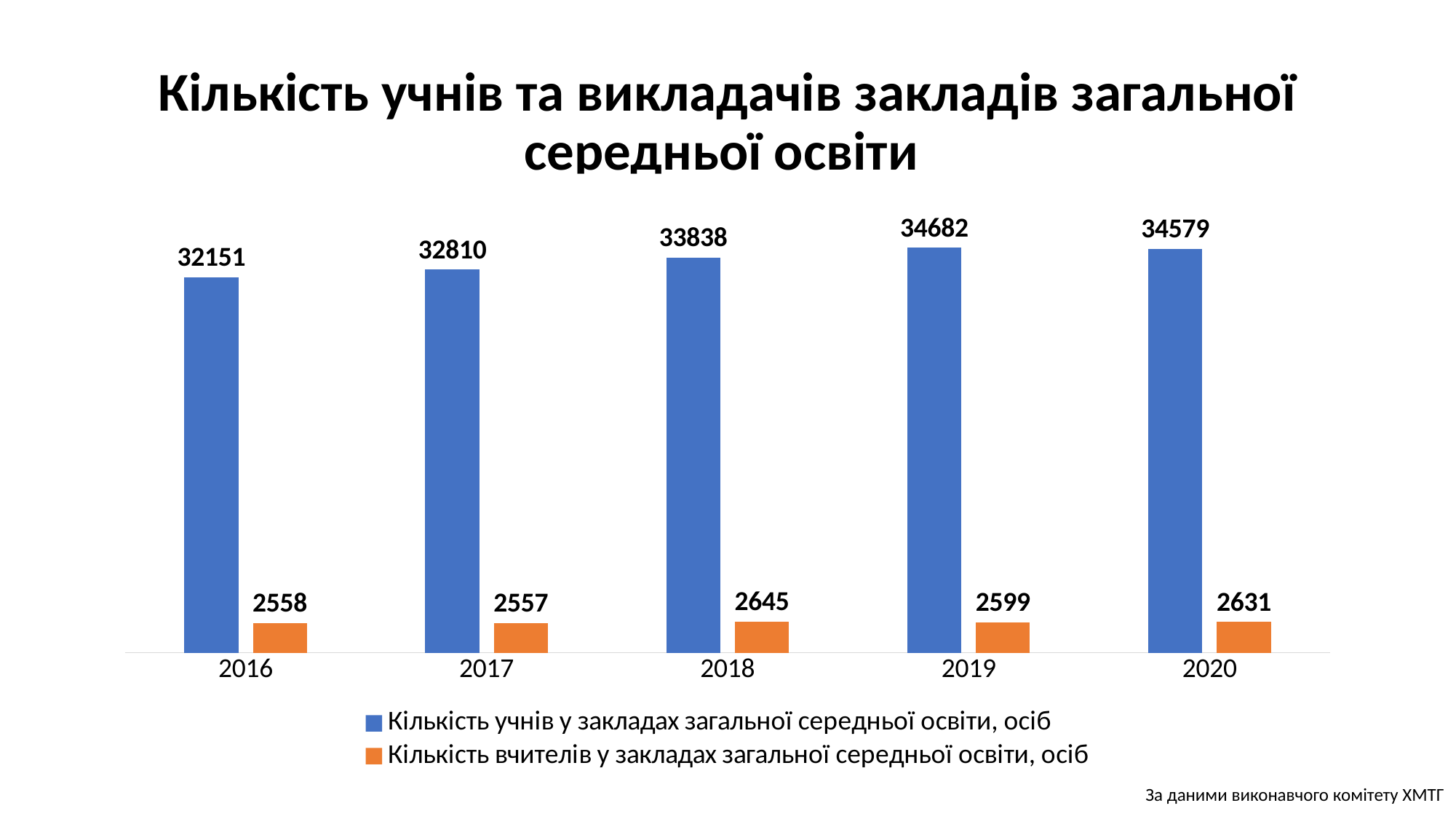
What kind of chart is shown on the slide? Bar chart How many series does the legend list? 2 What is the difference between the number of teachers in 2020 and in 2019? 32 In which year is the number of teachers (Кількість вчителів) highest? 2018 In which year is the number of students (Кількість учнів) highest? 2019 In which year is the number of students (Кількість учнів) lowest? 2016 What is the number of students (Кількість учнів) in 2018? 33838 Which year has more students, 2017 or 2020? 2020 What is the difference between the number of students in 2019 and in 2016? 2531 What is the number of students (Кількість учнів) in 2016? 32151 What is the number of teachers (Кількість вчителів) in 2020? 2631 How many years are shown on the x axis? 5